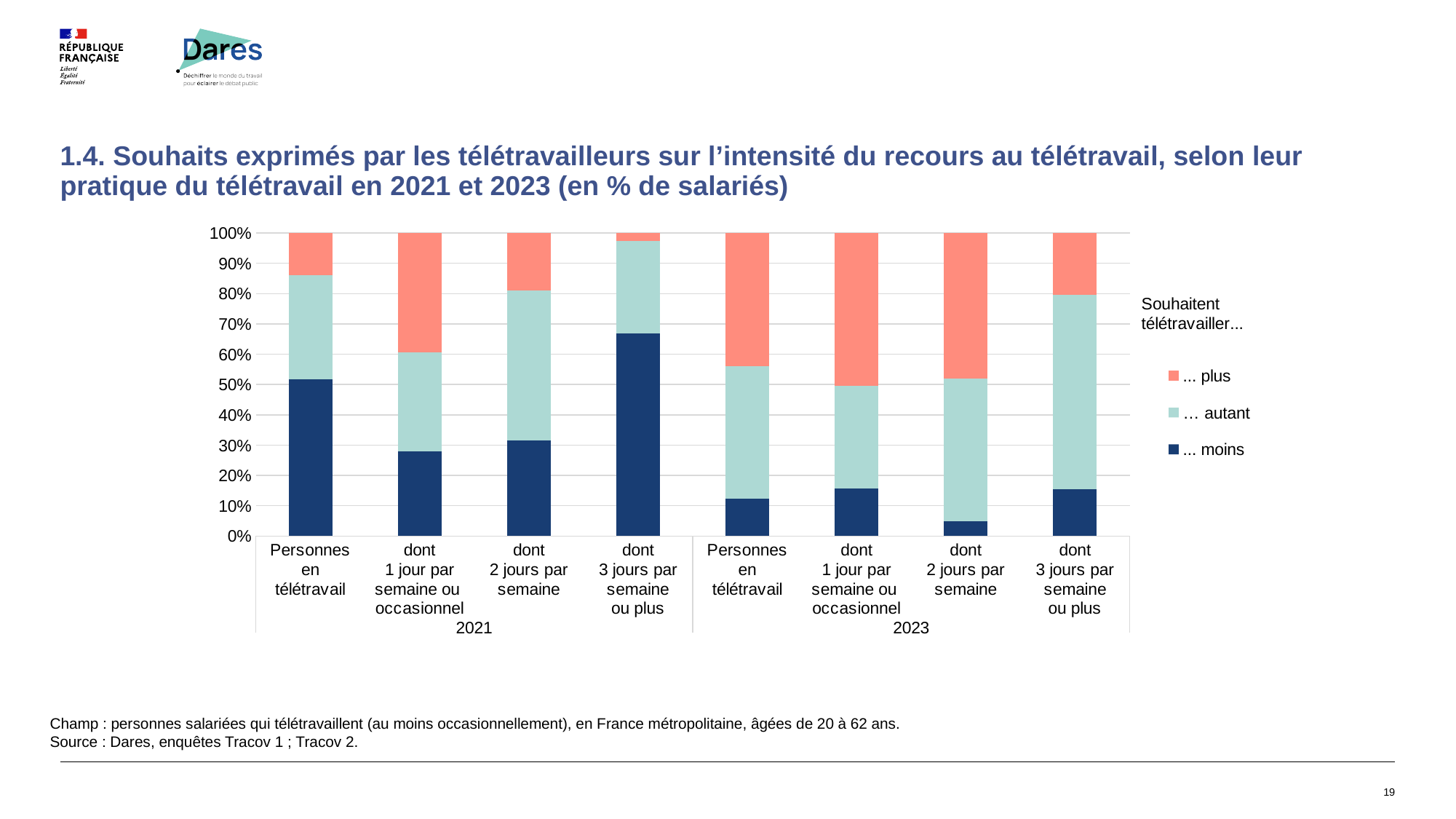
How many series does the legend list? 3 Which bar has the smallest '... moins' share? dont 2 jours par semaine (2023) In 2021, is the '... moins' share for 'dont 3 jours par semaine ou plus' greater or less than 60%? greater For 'Personnes en télétravail', is the '... moins' share larger in 2021 or in 2023? 2021 How many bars (categories) are plotted in the chart? 8 What is the title shown above the legend entries? Souhaitent télétravailler... In 2023, is the '... moins' share for 'Personnes en télétravail' greater or less than 20%? less What is the total of each stacked bar? 100% What kind of chart is shown on the slide? Stacked bar chart Which bar has the smallest '... plus' share? dont 3 jours par semaine ou plus (2021) Which bar has the largest '... moins' share? dont 3 jours par semaine ou plus (2021) In 2021, is the '... moins' share for 'dont 1 jour par semaine ou occasionnel' greater or less than 20%? greater